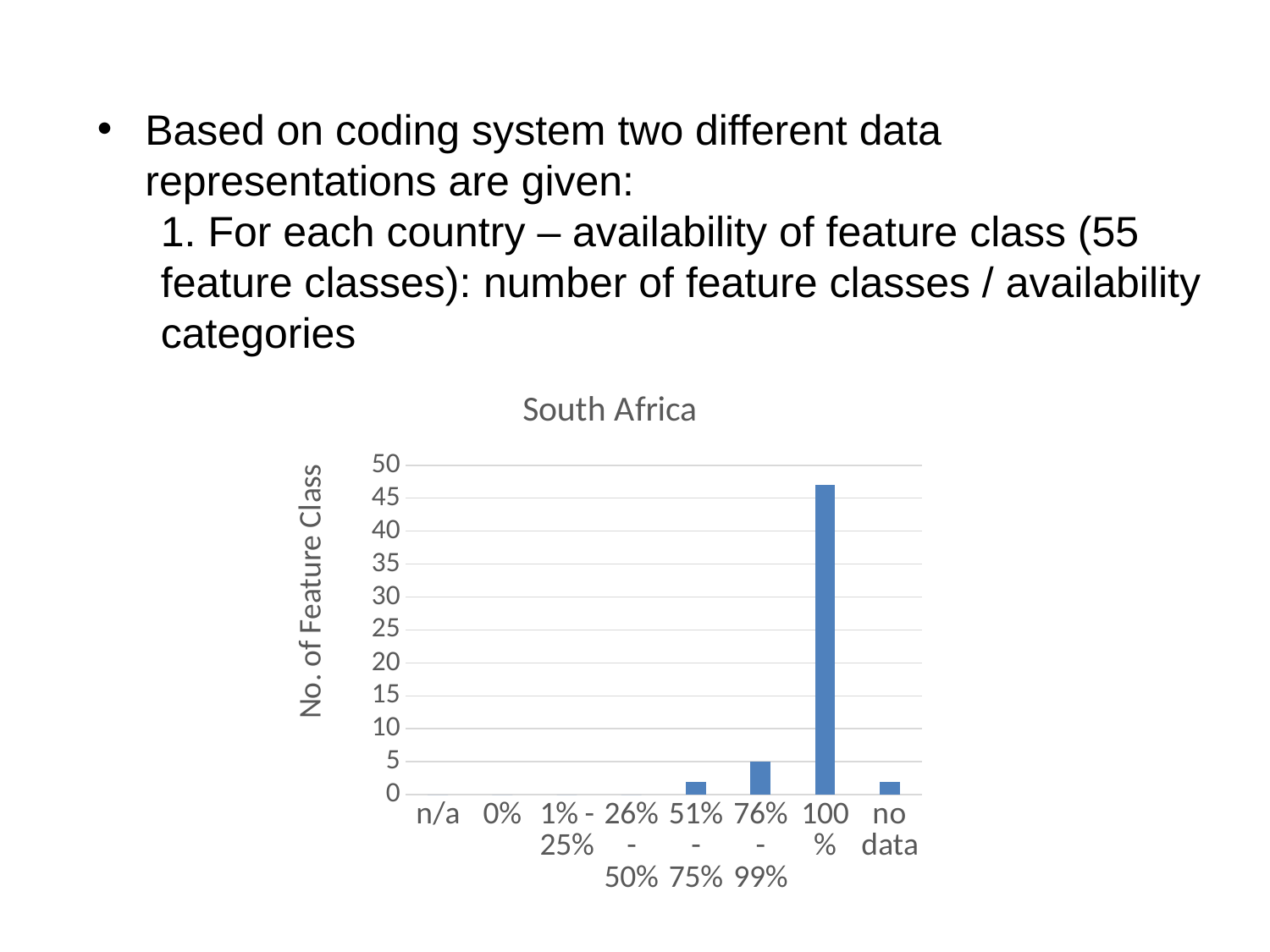
What is the label of the vertical axis? No. of Feature Class How many availability categories are shown on the x axis? 8 Which is larger, the value for 76% - 99% or the value for 51% - 75%? 76% - 99% What is the title of the chart? South Africa Is the value for the 100% category greater or less than 50? less What type of chart is shown on the slide? bar chart Which availability category has the highest number of feature classes? 100% Is the value for the no data category greater or less than 5? less Is the value for the 51% - 75% category greater or less than 5? less What is the number of feature classes for the 76% - 99% category? 5 Which is larger, the value for 100% or the value for no data? 100%